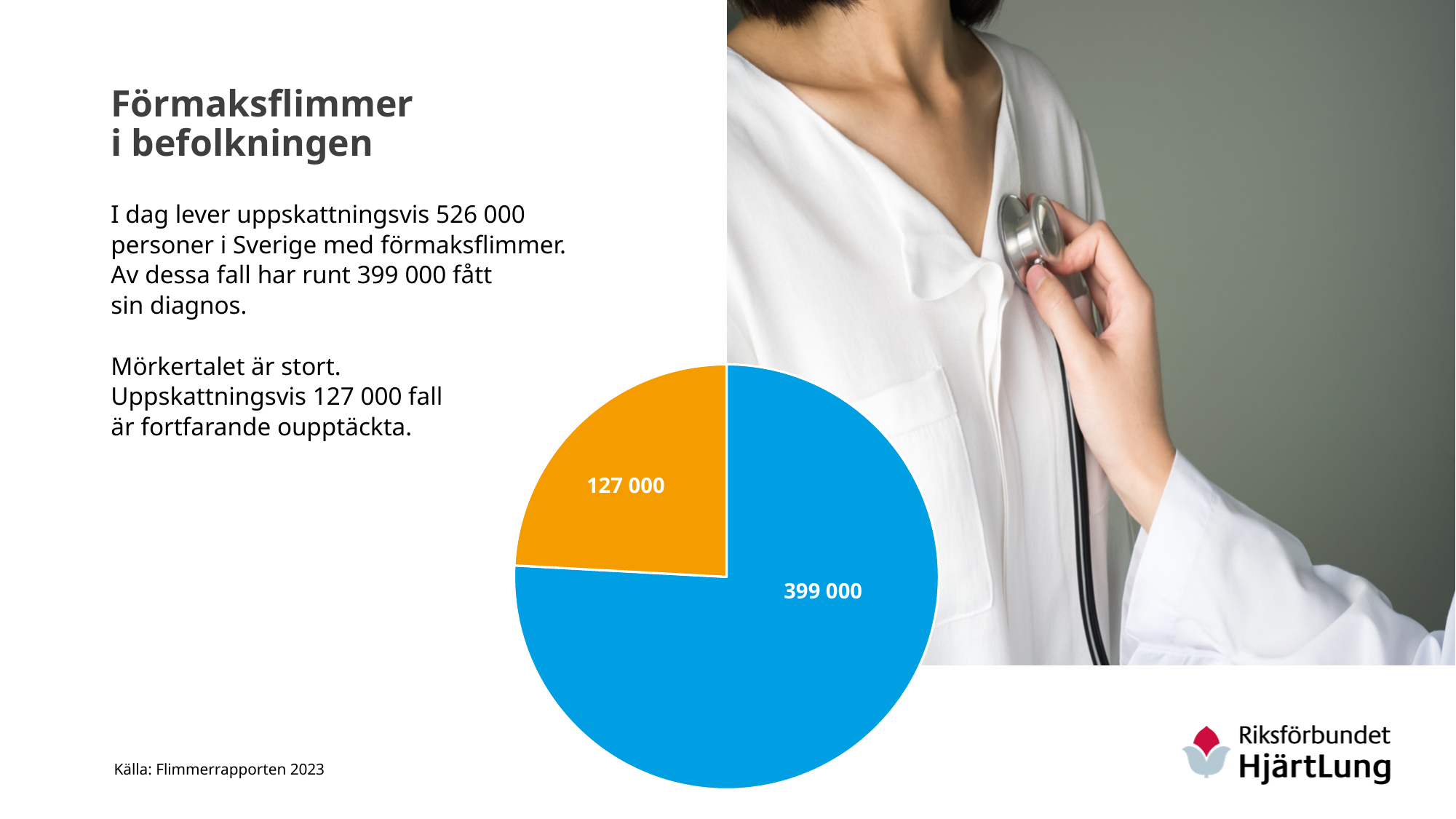
What is the title of the slide containing the pie chart? Förmaksflimmer i befolkningen What value is printed on the blue slice of the pie chart? 399 000 What colour is the slice labelled 399 000? blue Is the blue slice or the orange slice of the pie chart larger? the blue slice What is the difference between the two values shown in the pie chart? 272 000 What kind of chart is shown on the slide? pie chart Which slice of the pie chart has the smallest value? the orange slice (127 000) What is the total of the two values shown in the pie chart? 526 000 How many slices does the pie chart have? 2 Which slice of the pie chart has the largest value? the blue slice (399 000) What value is printed on the orange slice of the pie chart? 127 000